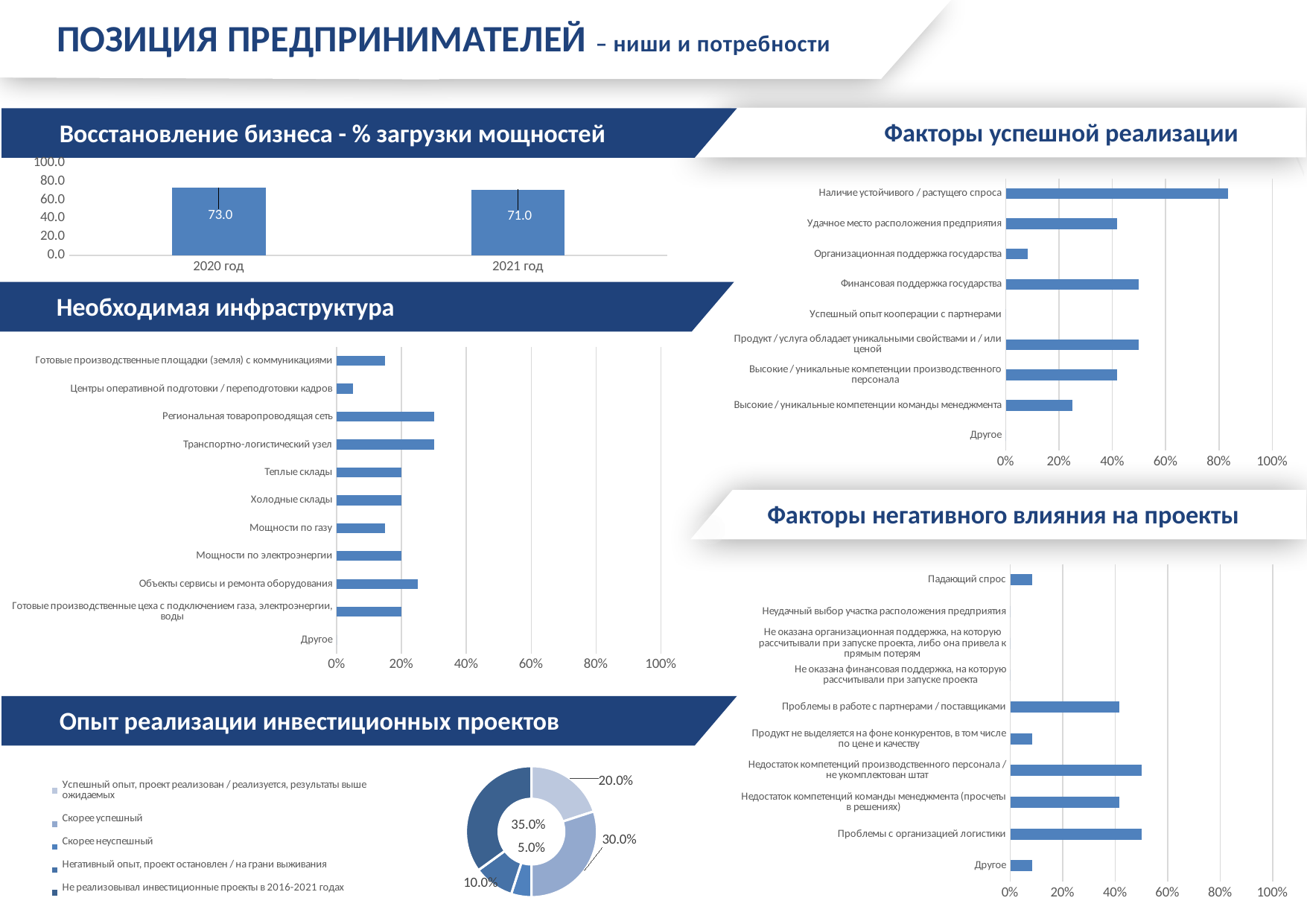
In the chart 'Восстановление бизнеса - % загрузки мощностей', what is the difference between the 2020 год and 2021 год values? 2.0 In the chart 'Необходимая инфраструктура', is the value for 'Центры оперативной подготовки / переподготовки кадров' greater or less than 20%? less What kind of chart is 'Восстановление бизнеса - % загрузки мощностей'? bar chart In the chart 'Опыт реализации инвестиционных проектов', what is the largest share shown? 35.0% In the chart 'Факторы негативного влияния на проекты', is the value for 'Падающий спрос' greater or less than 20%? less In the chart 'Восстановление бизнеса - % загрузки мощностей', what is the value for 2020 год? 73.0 In the chart 'Факторы успешной реализации', is the value for 'Организационная поддержка государства' greater or less than 20%? less In the chart 'Восстановление бизнеса - % загрузки мощностей', what is the value for 2021 год? 71.0 How many entries does the legend of the chart 'Опыт реализации инвестиционных проектов' list? 5 In the chart 'Факторы успешной реализации', which factor has the highest value? Наличие устойчивого / растущего спроса In the chart 'Восстановление бизнеса - % загрузки мощностей', which year has the higher value, 2020 год or 2021 год? 2020 год